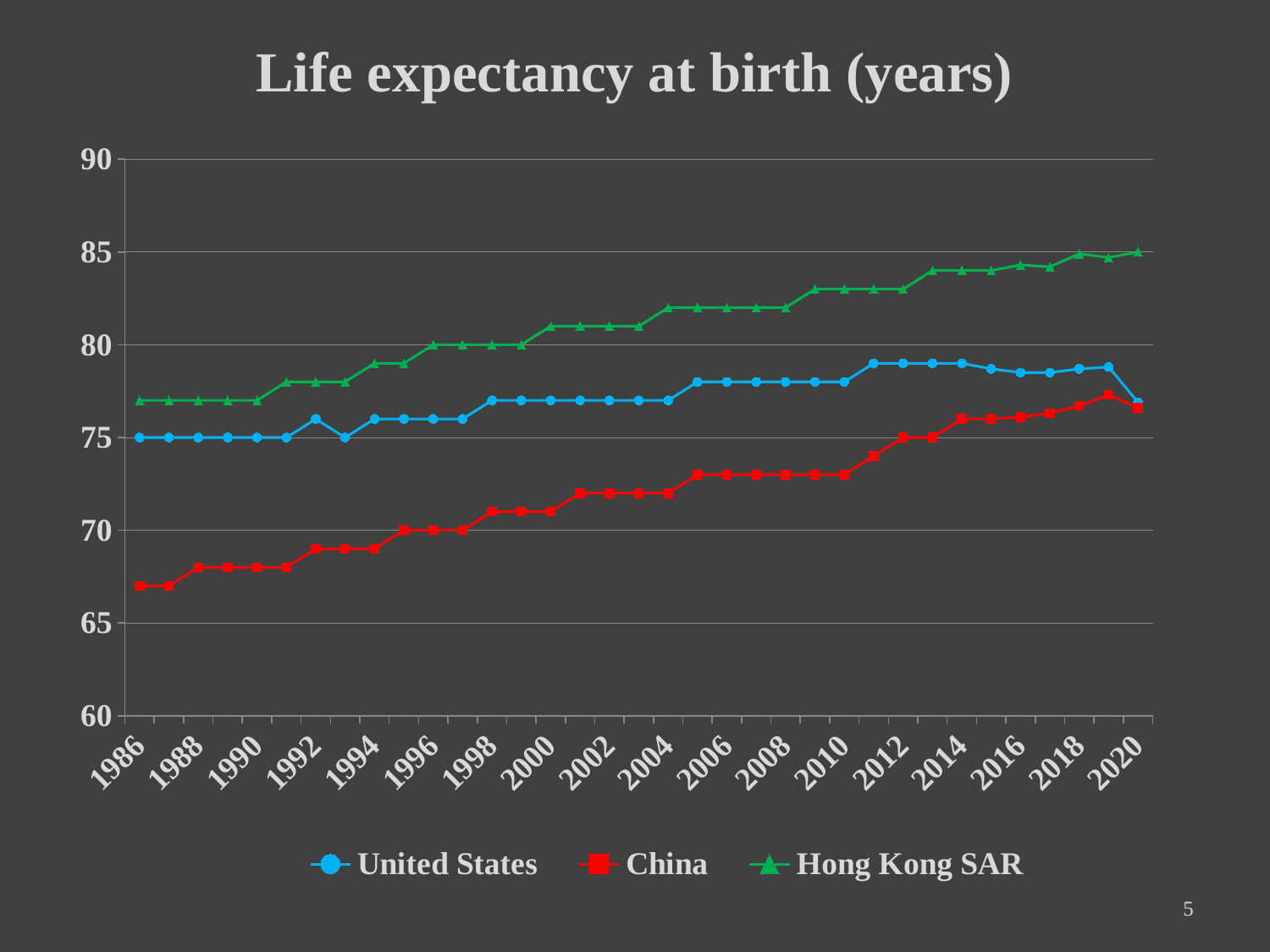
What is the title of the chart? Life expectancy at birth (years) What kind of chart is shown on the slide? line chart How many series does the legend list? 3 What is the life expectancy value for Hong Kong SAR in 1996? 80 Which series has the highest life expectancy in 2020? Hong Kong SAR Does the life expectancy for China generally rise or fall from 1986 to 2020? rise What is the life expectancy value for China in 1996? 70 Is the value for China in 1986 greater or less than 70? less What is the life expectancy value for the United States in 1986? 75 Which series has the lowest life expectancy in 1986? China Is the value for Hong Kong SAR in 2010 greater or less than 80? greater What is the life expectancy value for Hong Kong SAR in 2020? 85